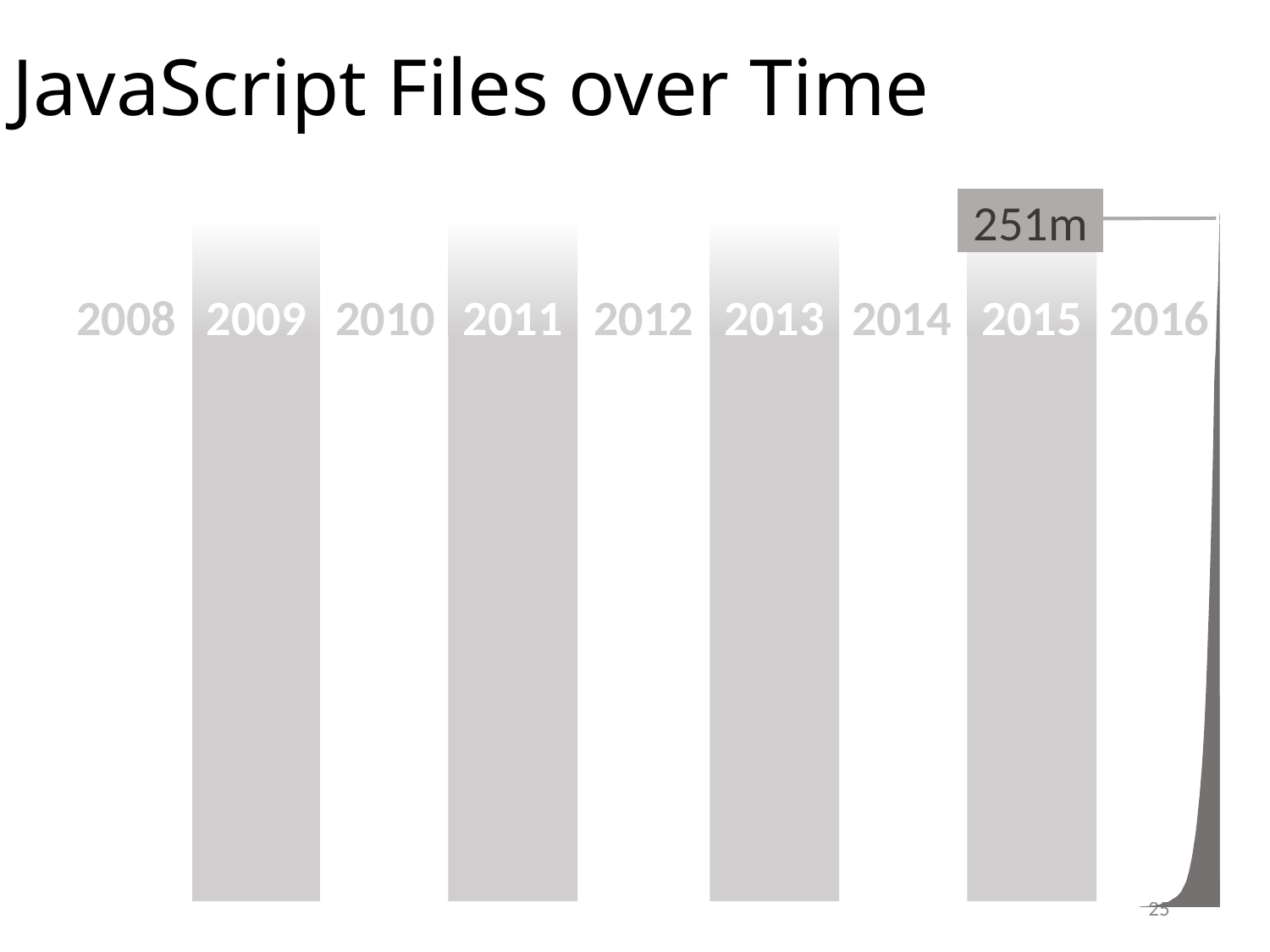
Is the value for 2016 larger or smaller than the value for 2012? larger How many years are labelled along the x axis? 9 What is the title of the chart on the slide? JavaScript Files over Time What is the first year labelled on the x axis? 2008 Which year has the highest value on the chart? 2016 Do the values rise or fall from 2008 to 2016? rise What value is labelled at the peak of the chart, at the right-hand end? 251m What kind of chart is shown on the slide? area chart